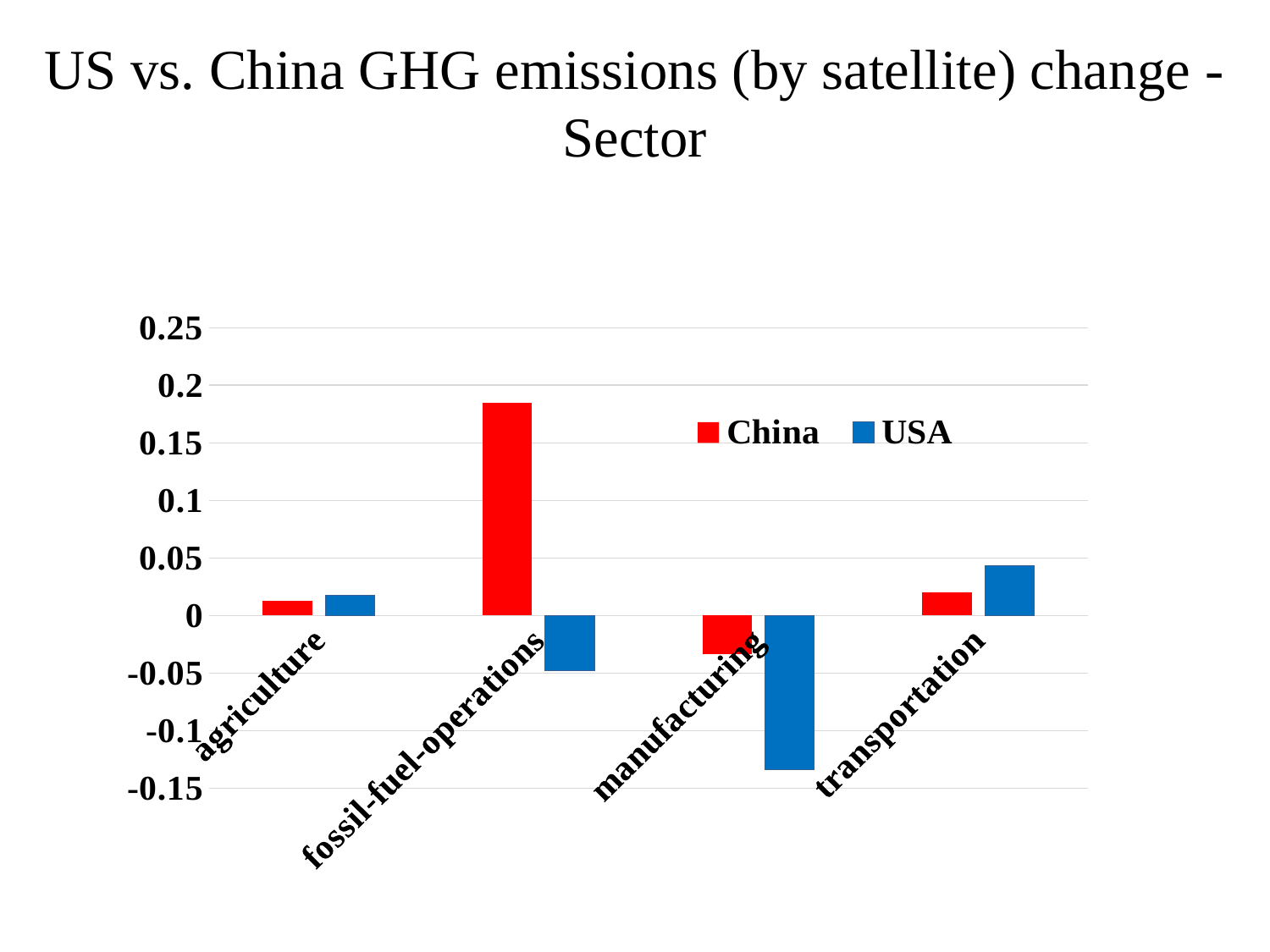
What is the title of the chart? US vs. China GHG emissions (by satellite) change - Sector Which colour represents the USA series in the legend? blue For which sector is the USA value lowest? manufacturing For transportation, which series has the larger value, China or USA? USA Is the USA value for fossil-fuel-operations greater or less than 0? less What kind of chart is shown on the slide? bar chart How many sector categories are shown on the x axis? 4 Is the USA value for manufacturing greater or less than -0.1? less Is the China value for fossil-fuel-operations greater or less than 0.15? greater How many series does the legend list? 2 For fossil-fuel-operations, which series has the larger value, China or USA? China For which sector is the China value highest? fossil-fuel-operations